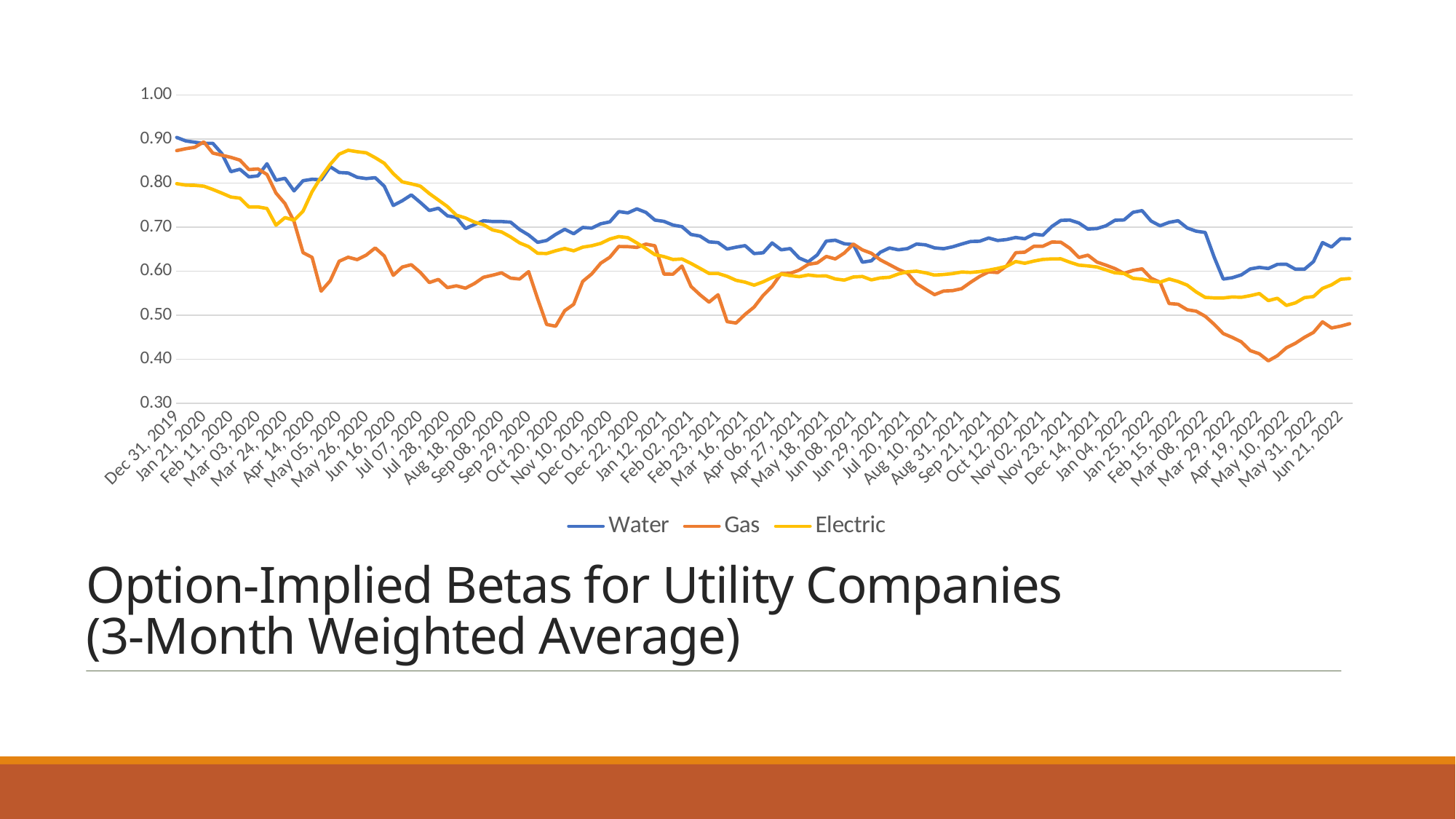
Does the Gas series overall rise or fall from Dec 31, 2019 to Jun 21, 2022? Fall At May 26, 2020, which is higher, Electric or Gas? Electric Is the value for Gas at Jun 21, 2022 greater or less than 0.50? less Is the value for Electric at May 26, 2020 greater or less than 0.80? greater Is the value for Water at Jun 21, 2022 greater or less than 0.60? greater What kind of chart is shown on the slide? Line chart Which series has the highest value at Jun 21, 2022? Water Which series has the lowest value at Jun 21, 2022? Gas How many series does the legend list? 3 Which colour is used for the Gas series? Orange What is the title of the chart on the slide? Option-Implied Betas for Utility Companies (3-Month Weighted Average)